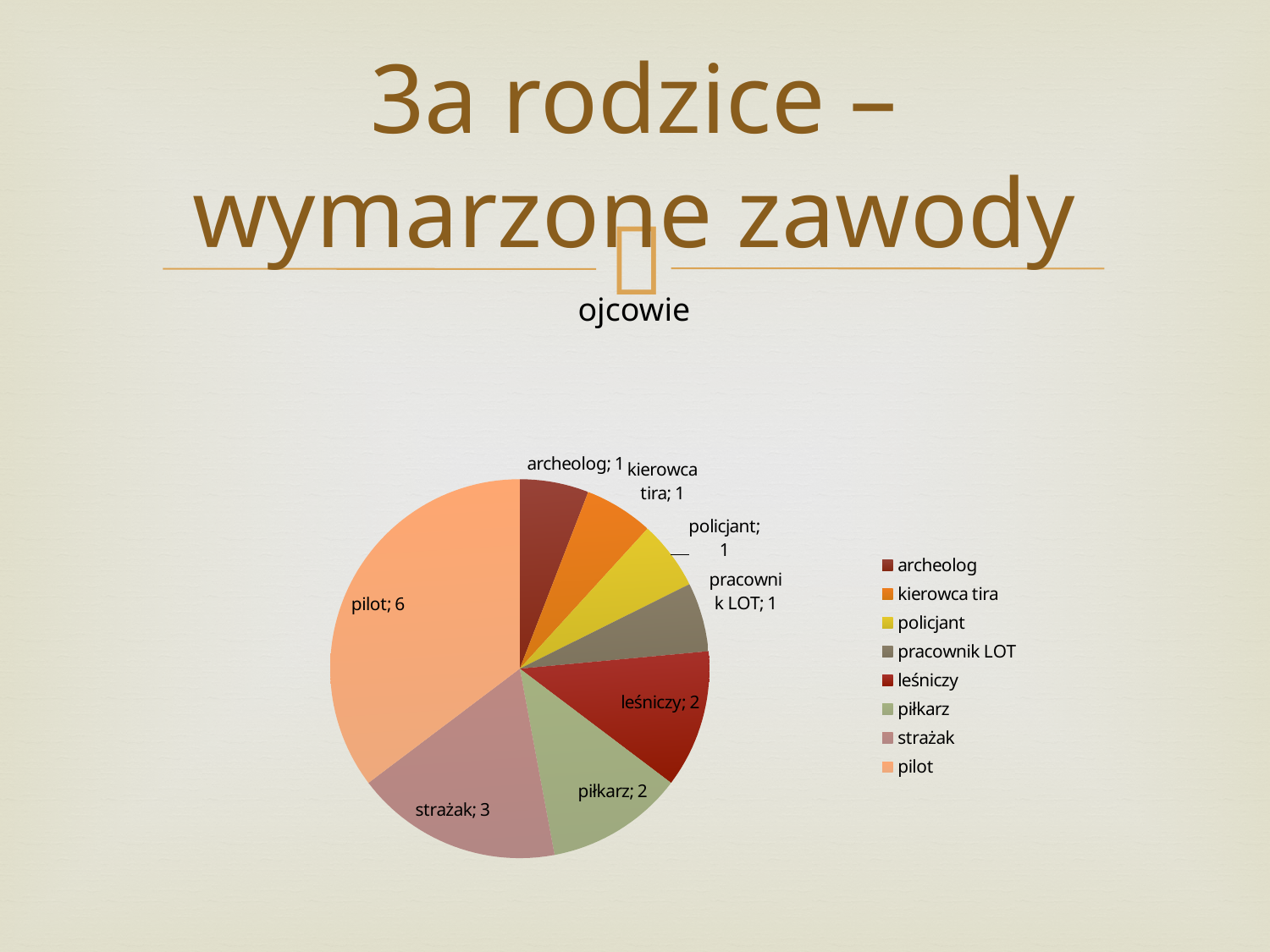
What is the title of the chart? ojcowie Which category has the largest slice? pilot What is the value for pilot? 6 What is the total of all the values in the pie chart? 17 What kind of chart is shown on the slide? pie chart How many categories does the pie chart have? 8 Which is larger, the value for piłkarz or the value for policjant? piłkarz Which legend entry is listed last? pilot What is the value for strażak? 3 What is the value for leśniczy? 2 What is the difference between the values for pilot and strażak? 3 What is the value for pracownik LOT? 1